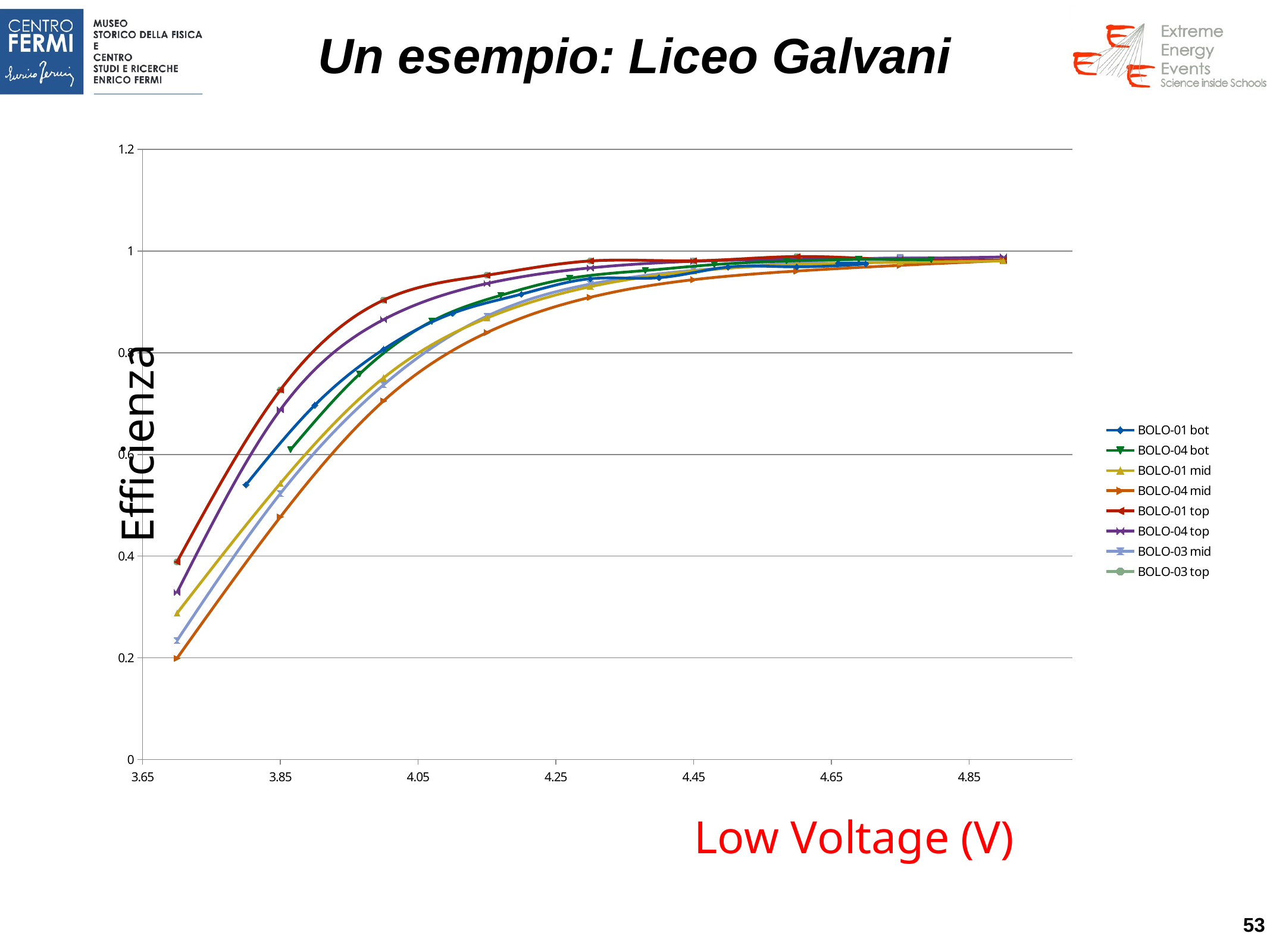
Is the value for BOLO-04 top at the lowest plotted voltage (about 3.7 V) greater or less than 0.4? less What is the label of the y axis? Efficienza Which series has the lowest value at the lowest plotted voltage (about 3.7 V)? BOLO-04 mid Is the value for BOLO-01 bot at its first plotted point (about 3.8 V) greater or less than 0.6? less What is the label of the x axis? Low Voltage (V) Is the value for BOLO-04 mid at 3.85 V greater or less than 0.4? greater How many series does the legend list? 8 Do the efficiency values rise or fall as Low Voltage increases along the x axis? rise What kind of chart is shown on the slide? line chart At 3.85 V, which series has the larger value, BOLO-01 top or BOLO-04 mid? BOLO-01 top